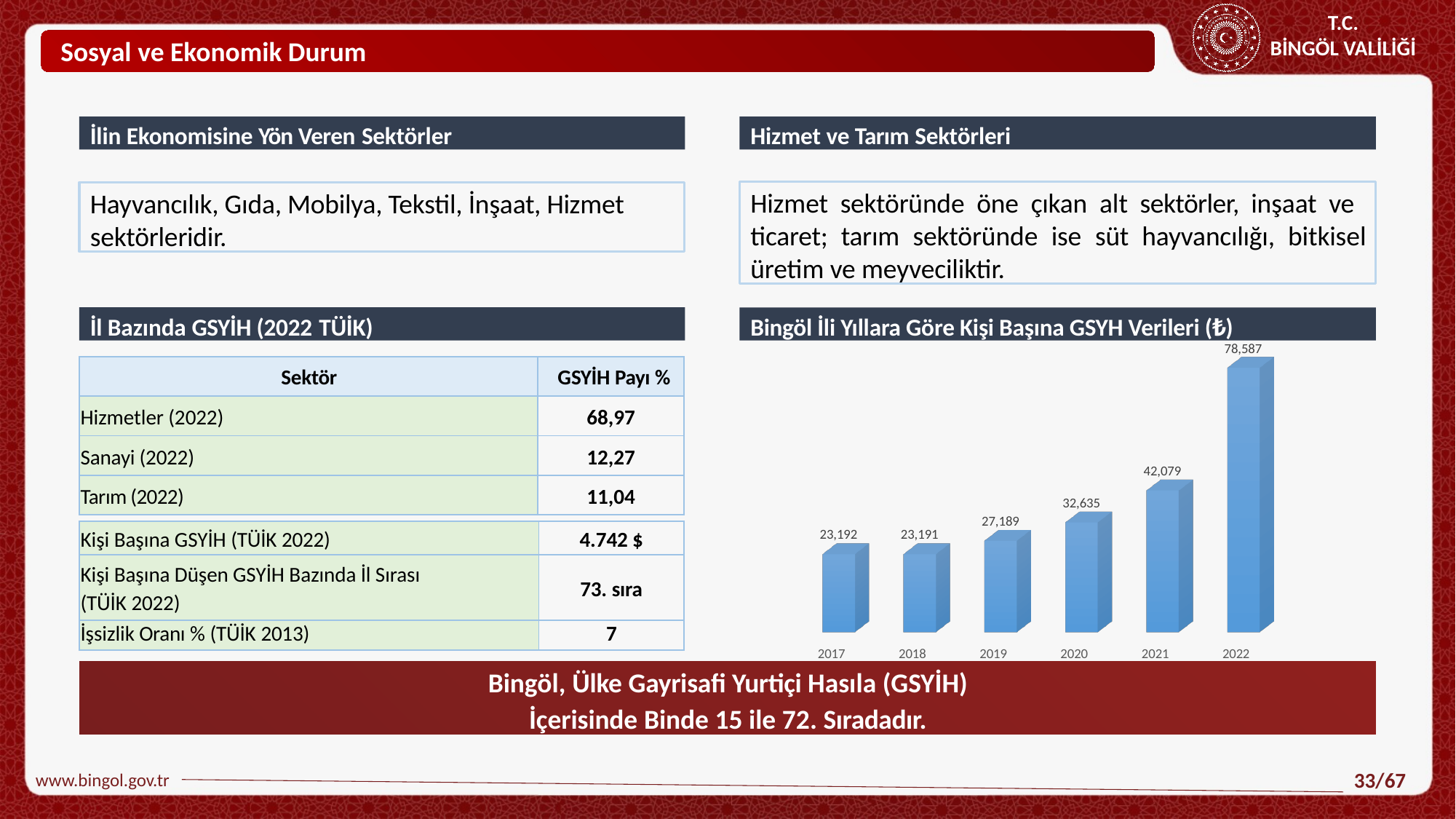
Which year has the highest per-capita GSYH in the chart? 2022 What is the per-capita GSYH value shown for 2022 in the chart? 78,587 What is the difference between the 2020 and 2019 per-capita GSYH values in the chart? 5,446 Do the per-capita GSYH values rise or fall from 2017 to 2022 in the chart? rise How many years are shown in the per-capita GSYH chart? 6 What is the title of the chart on the slide? Bingöl İli Yıllara Göre Kişi Başına GSYH Verileri (₺) What is the per-capita GSYH value shown for 2019 in the chart? 27,189 What is the difference between the 2022 and 2021 per-capita GSYH values in the chart? 36,508 Is the per-capita GSYH value for 2021 larger or smaller than the value for 2019? larger What kind of chart is used to show Bingöl's per-capita GDP by year? bar chart What is the per-capita GSYH value shown for 2020 in the chart? 32,635 What is the per-capita GSYH value shown for 2017 in the chart? 23,192